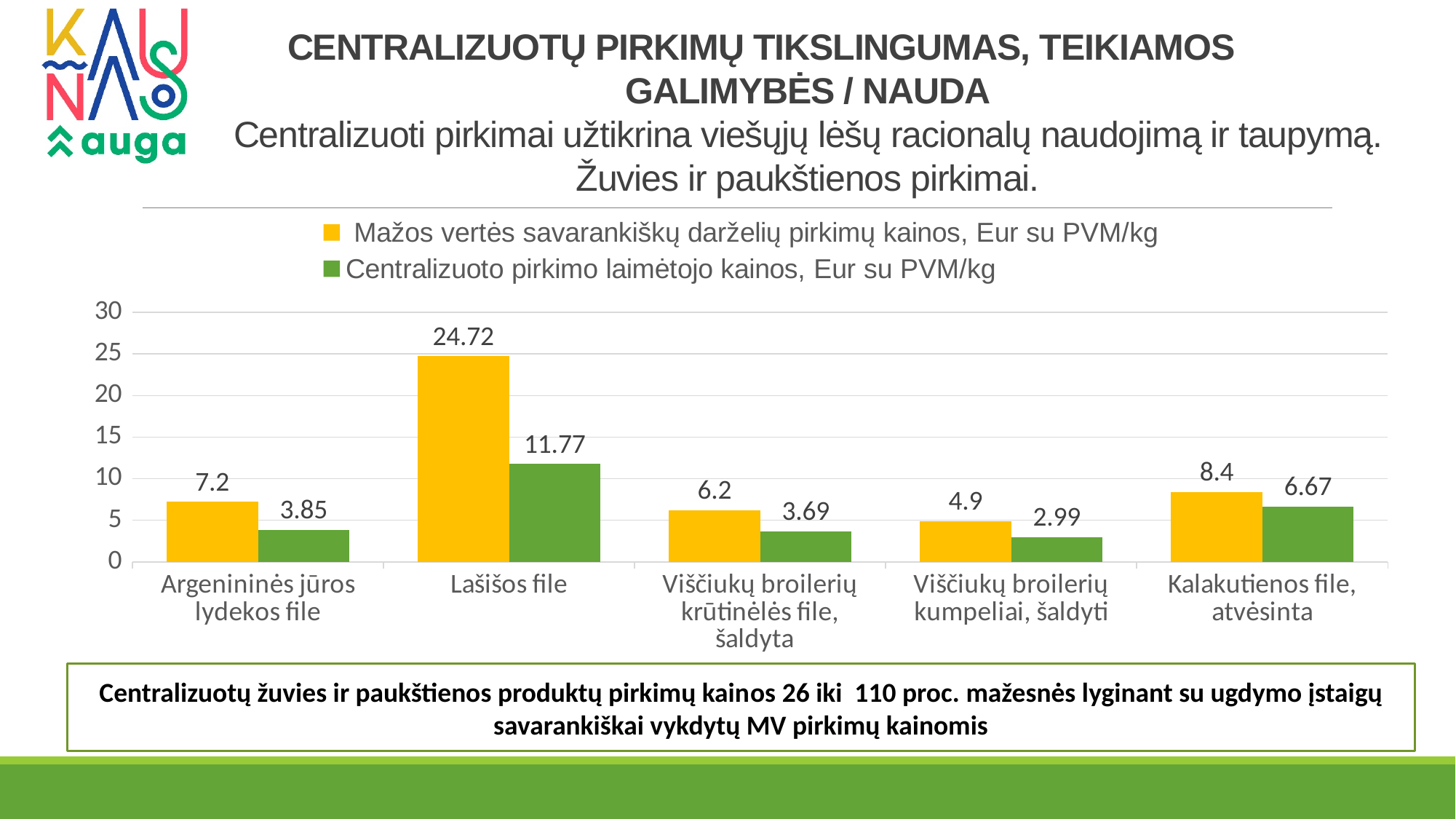
Which colour represents 'Centralizuoto pirkimo laimėtojo kainos, Eur su PVM/kg' in the chart? Green What kind of chart is shown on the slide? Bar chart How many series does the legend list? 2 Which category has the lowest value for 'Centralizuoto pirkimo laimėtojo kainos, Eur su PVM/kg'? Viščiukų broilerių kumpeliai, šaldyti How many product categories are shown on the x axis? 5 Which is larger for Viščiukų broilerių krūtinėlės file, šaldyta: the 'Mažos vertės savarankiškų darželių pirkimų kainos' value or the 'Centralizuoto pirkimo laimėtojo kainos' value? Mažos vertės savarankiškų darželių pirkimų kainos What is the difference between the two series' values for Lašišos file? 12.95 What is the value of 'Mažos vertės savarankiškų darželių pirkimų kainos, Eur su PVM/kg' for Lašišos file? 24.72 What is the difference between the two series' values for Argenininės jūros lydekos file? 3.35 Which category has the highest value for 'Mažos vertės savarankiškų darželių pirkimų kainos, Eur su PVM/kg'? Lašišos file What is the value of 'Centralizuoto pirkimo laimėtojo kainos, Eur su PVM/kg' for Kalakutienos file, atvėsinta? 6.67 What is the value of 'Centralizuoto pirkimo laimėtojo kainos, Eur su PVM/kg' for Viščiukų broilerių kumpeliai, šaldyti? 2.99